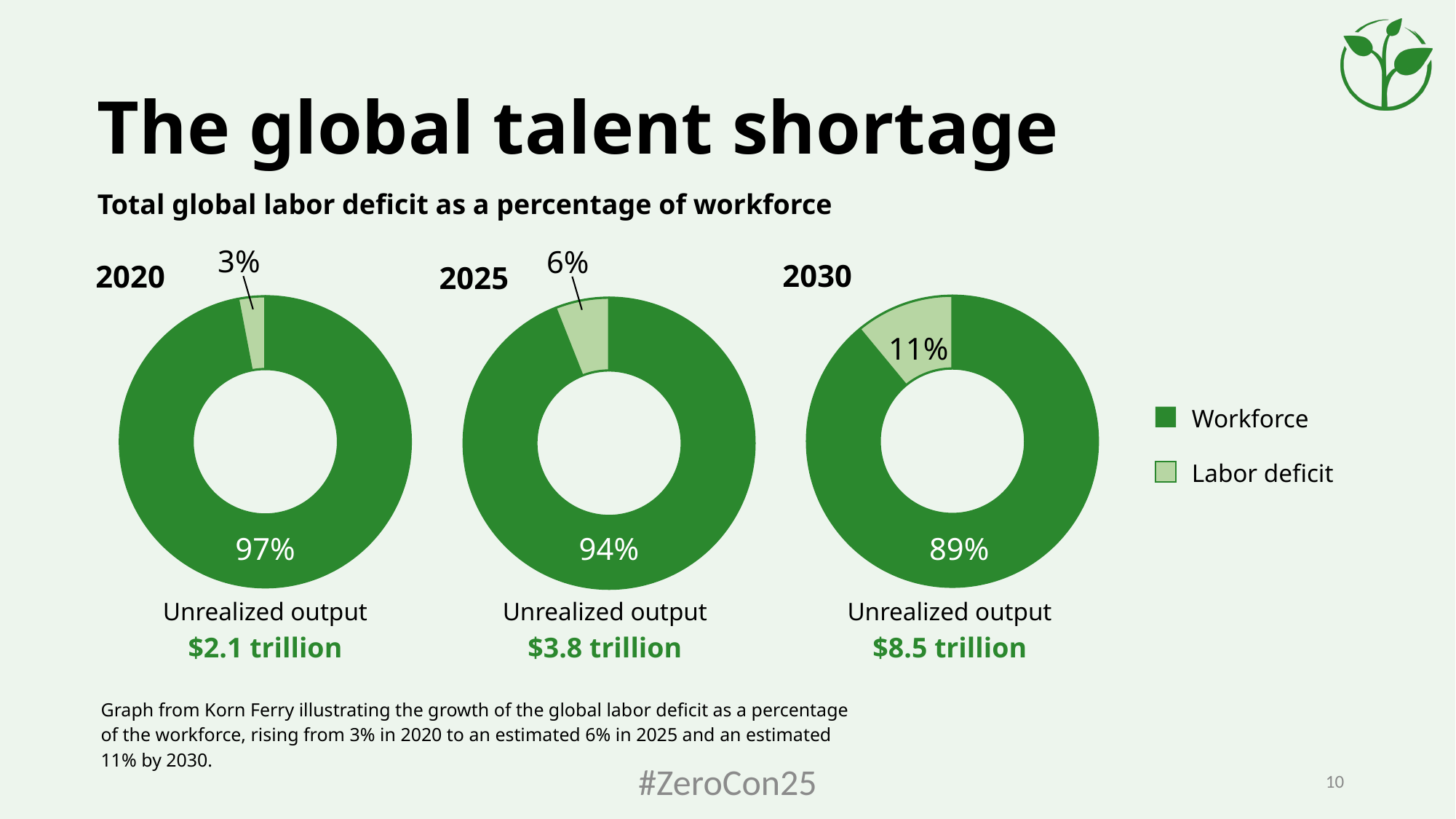
How many series does the legend list? 2 What kind of chart is used to show the labor deficit for each year? Doughnut chart In the 2030 chart, what percentage is the workforce? 89% Which year's chart shows the largest labor deficit share? 2030 In the 2020 chart, what percentage is the labor deficit? 3% Does the labor deficit share rise or fall from 2020 to 2030? Rise Which year's chart shows the smallest labor deficit share? 2020 How many doughnut charts are on the slide? 3 In the 2025 chart, what percentage is the workforce? 94% What is the difference between the labor deficit share in 2030 and in 2020? 8% Is the labor deficit share larger in the 2025 chart or the 2020 chart? 2025 In the 2030 chart, what percentage is the labor deficit? 11%